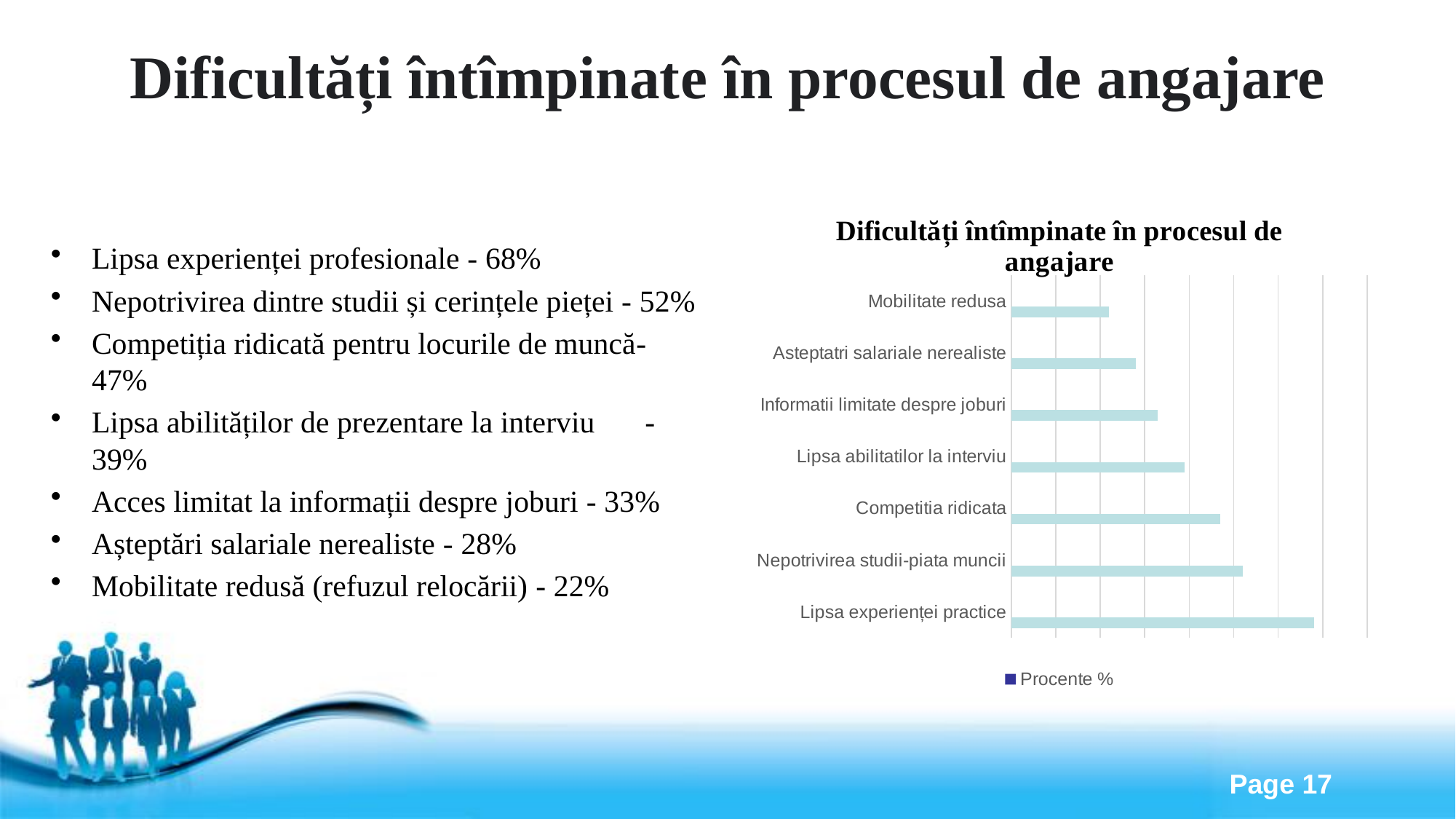
Which has the larger value: Informatii limitate despre joburi or Asteptatri salariale nerealiste? Informatii limitate despre joburi What is the title of the chart? Dificultăți întîmpinate în procesul de angajare Which has the larger value: Nepotrivirea studii-piata muncii or Competitia ridicata? Nepotrivirea studii-piata muncii How many series does the chart legend list? 1 Which has the larger value: Competitia ridicata or Lipsa abilitatilor la interviu? Competitia ridicata Which category has the highest value in the chart? Lipsa experienței practice Which category has the lowest value in the chart? Mobilitate redusa What is the name of the series shown in the chart legend? Procente % How many categories does the chart show? 7 What kind of chart is shown on the slide? bar chart